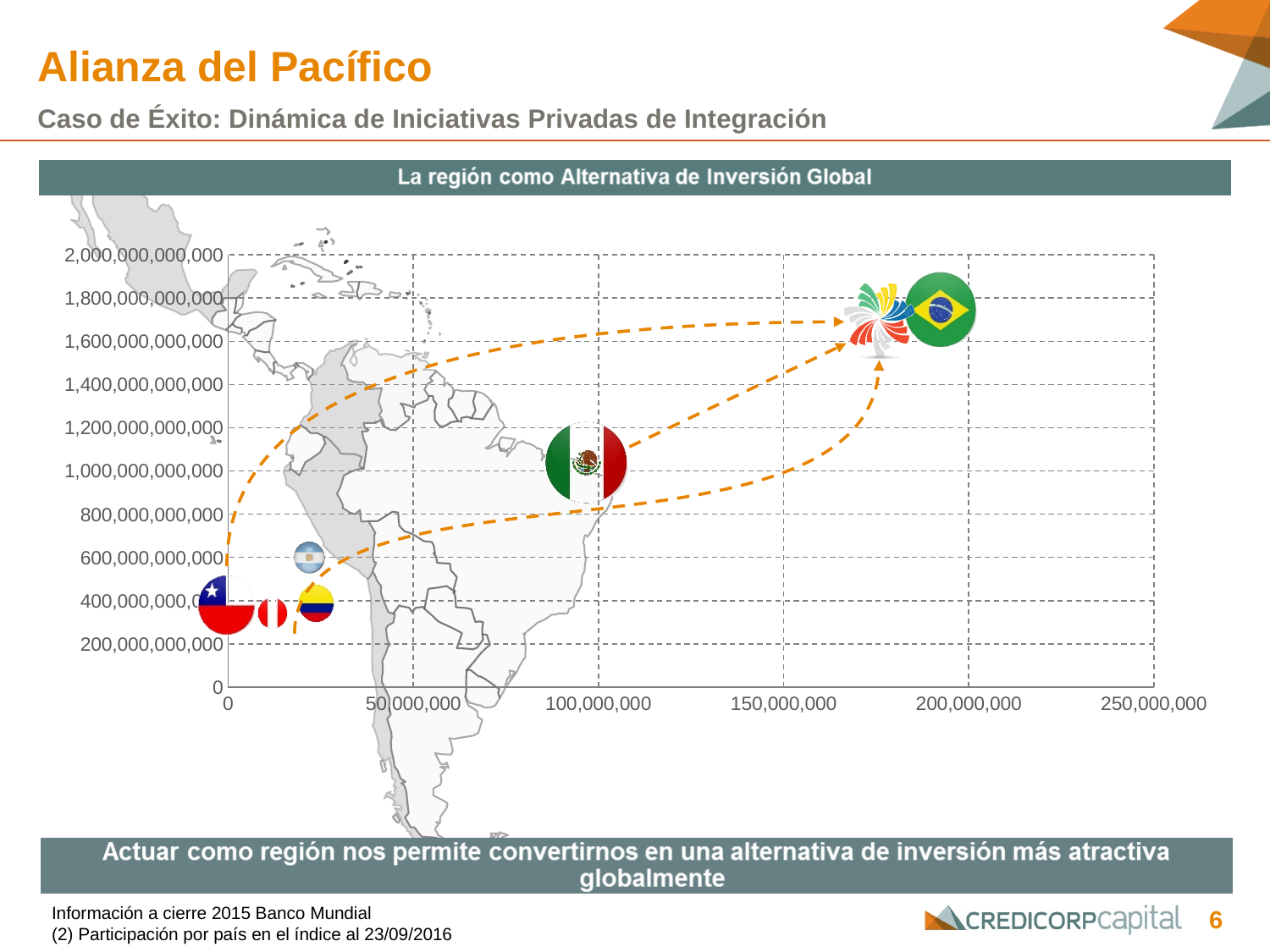
Which country's marker is highest on the vertical axis? Brazil Is the horizontal-axis value for Brazil greater or less than 150,000,000? greater What is the title of the chart? La región como Alternativa de Inversión Global Which has the higher vertical-axis value, Brazil or Mexico? Brazil What kind of chart is shown on the slide? Scatter (bubble) chart Which has the higher vertical-axis value, Mexico or Argentina? Mexico What is the highest value shown on the vertical axis? 2,000,000,000,000 Is the vertical-axis value for Mexico greater or less than 1,200,000,000,000? less Is the vertical-axis value for Brazil greater or less than 1,600,000,000,000? greater